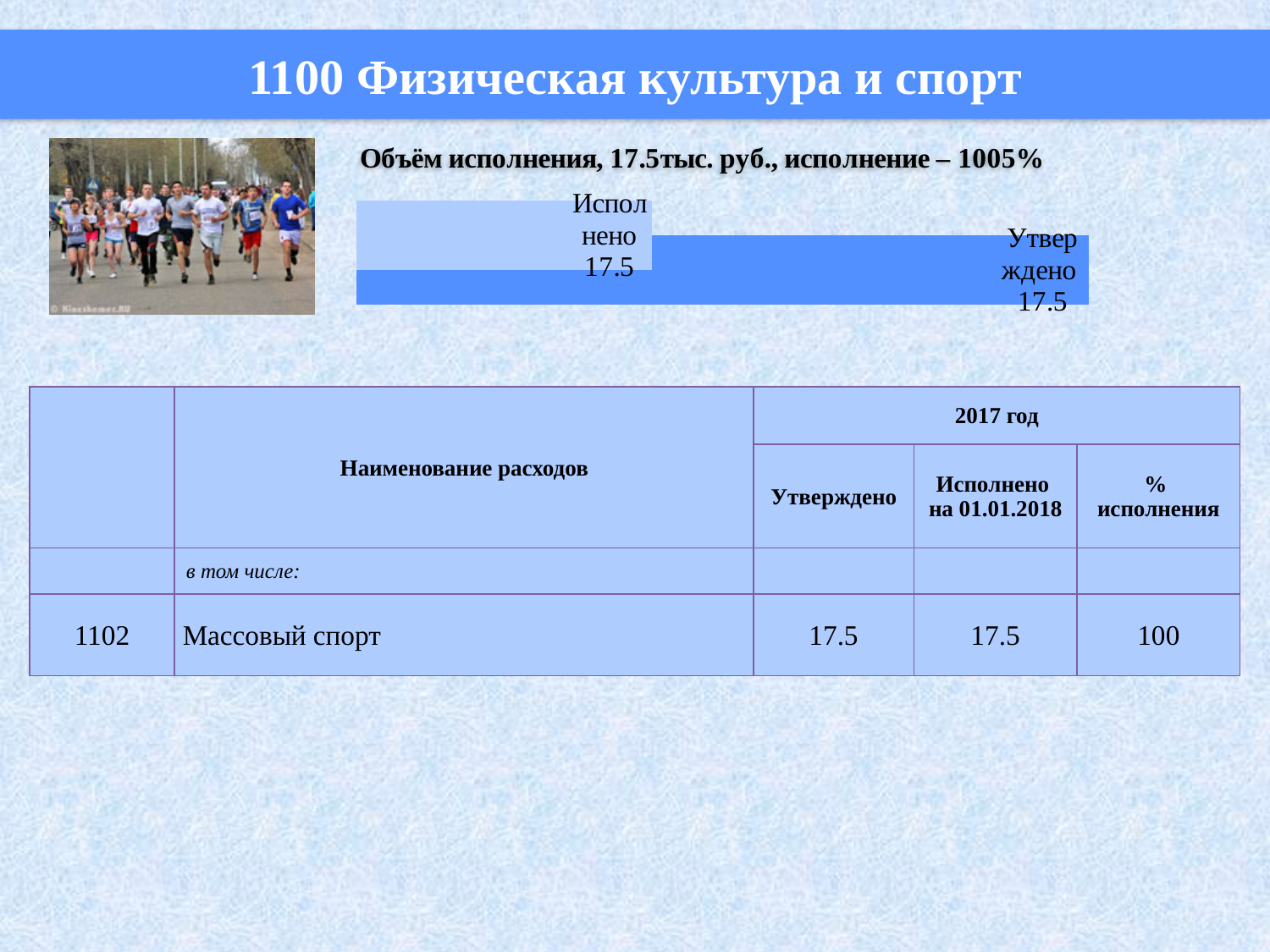
What value is shown for the bar labelled Утверждено? 17.5 Which bar is drawn in the darker blue colour, Исполнено or Утверждено? Утверждено What kind of chart is shown on the slide? bar chart How many bars does the chart contain? 2 Are the bars in the chart oriented horizontally or vertically? horizontally What value is shown for the bar labelled Исполнено? 17.5 What is the difference between the Утверждено value and the Исполнено value? 0